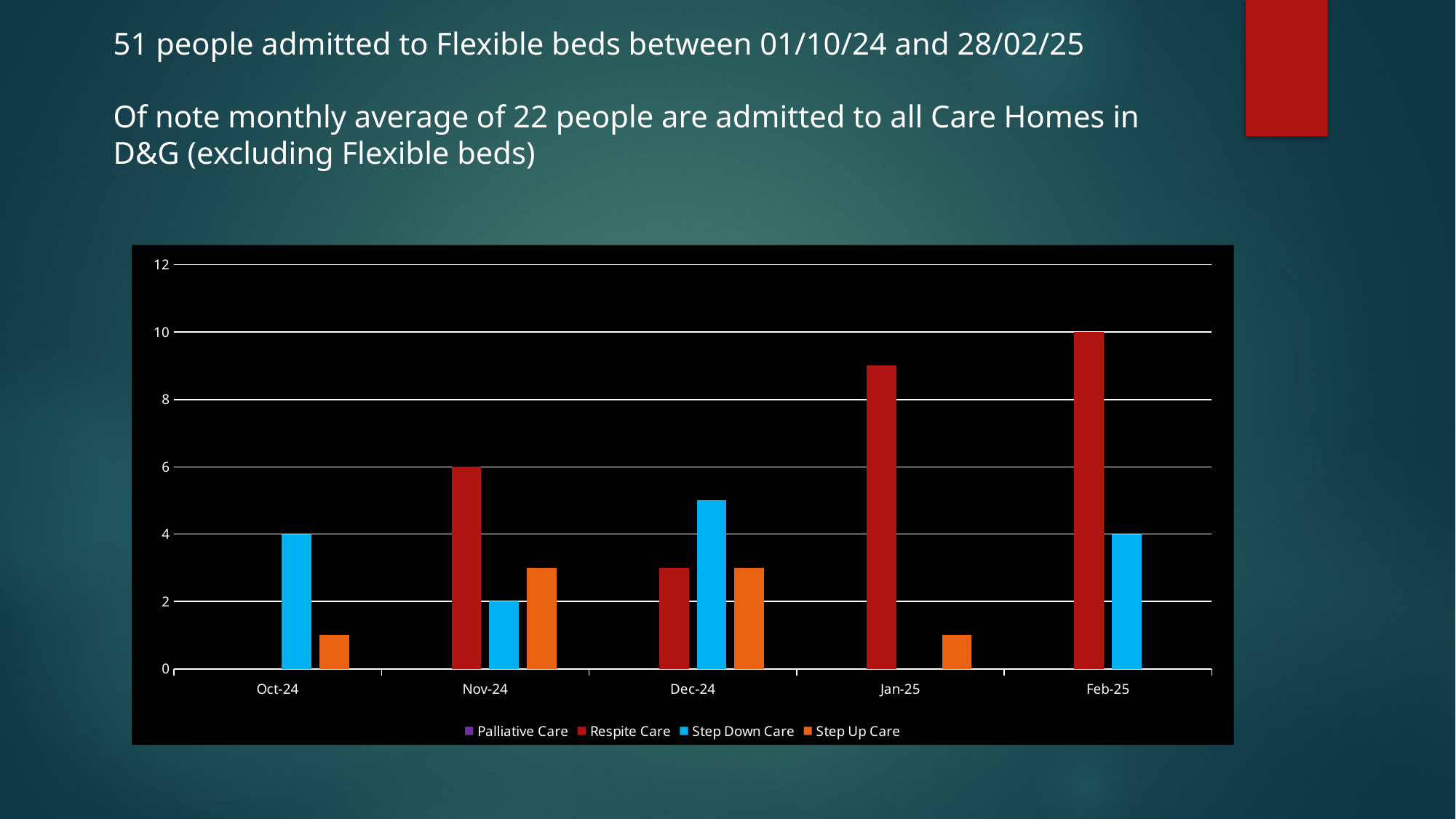
Is the value for Step Down Care in Dec-24 greater or less than 4? greater Which is larger in Dec-24, Respite Care or Step Down Care? Step Down Care Is the value for Respite Care in Jan-25 greater or less than 8? greater What is the value for Respite Care in Feb-25? 10 What is the value for Step Down Care in Oct-24? 4 Does the Respite Care value rise or fall from Dec-24 to Feb-25? rise How many months are shown on the x axis? 5 In which month is the Respite Care bar highest? Feb-25 How many series does the legend list? 4 What is the value for Step Down Care in Nov-24? 2 What kind of chart is shown on the slide? bar chart What is the value for Respite Care in Nov-24? 6